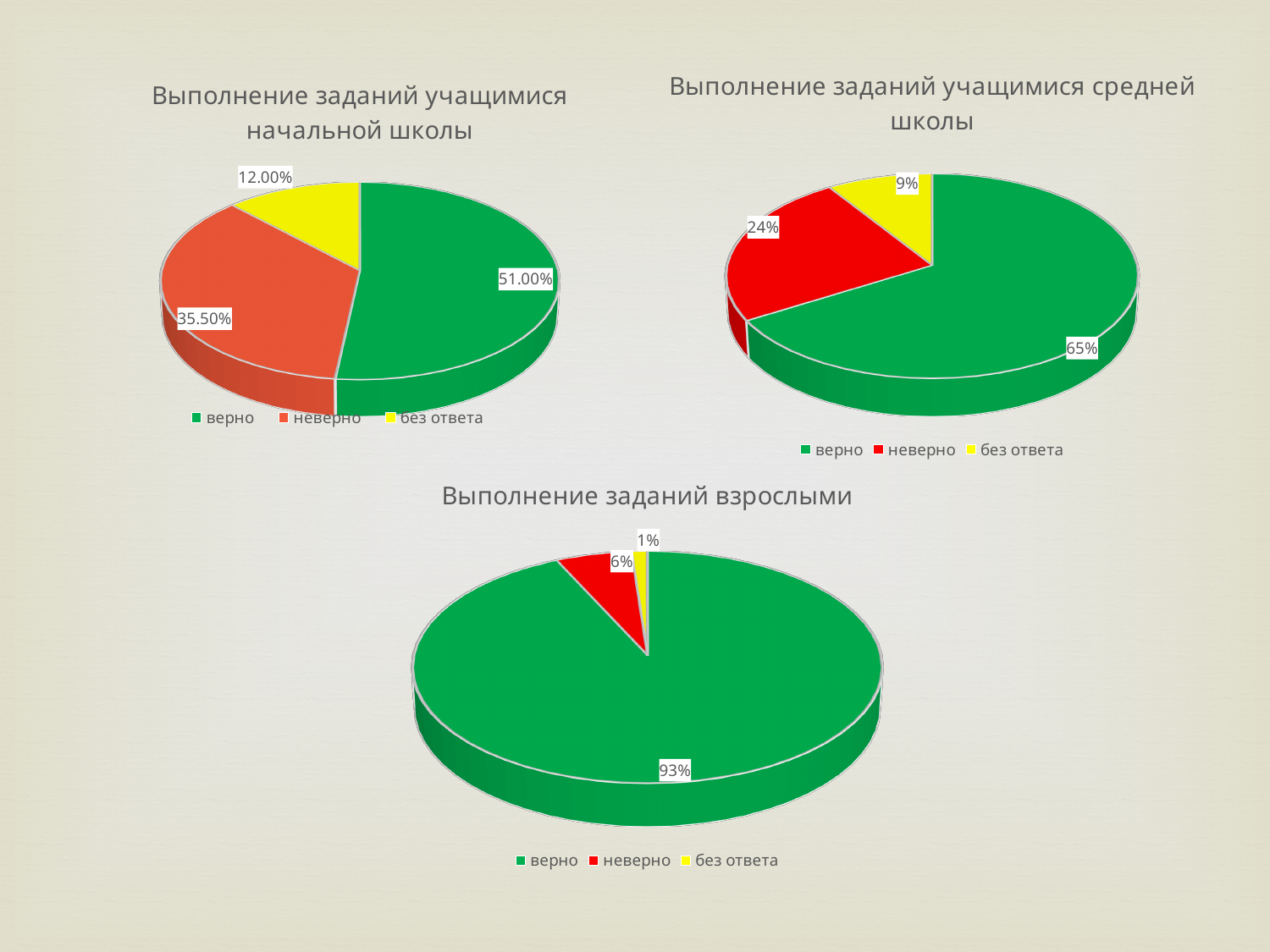
In the chart titled "Выполнение заданий учащимися начальной школы", what is the value for "верно"? 51.00% In the chart titled "Выполнение заданий взрослыми", which is larger, "неверно" or "без ответа"? неверно What kind of chart is "Выполнение заданий взрослыми"? pie chart In the chart titled "Выполнение заданий учащимися средней школы", what is the value for "неверно"? 24% In the chart titled "Выполнение заданий взрослыми", what is the value for "без ответа"? 1% How many entries does the legend of the chart titled "Выполнение заданий учащимися начальной школы" list? 3 In the chart titled "Выполнение заданий учащимися средней школы", which category has the largest slice? верно In the chart titled "Выполнение заданий учащимися средней школы", what is the value for "без ответа"? 9% In the chart titled "Выполнение заданий взрослыми", what is the value for "верно"? 93% In the chart titled "Выполнение заданий учащимися начальной школы", which category has the smallest slice? без ответа In the chart titled "Выполнение заданий учащимися средней школы", what is the difference between "верно" and "неверно"? 41% In the chart titled "Выполнение заданий учащимися начальной школы", what is the value for "неверно"? 35.50%